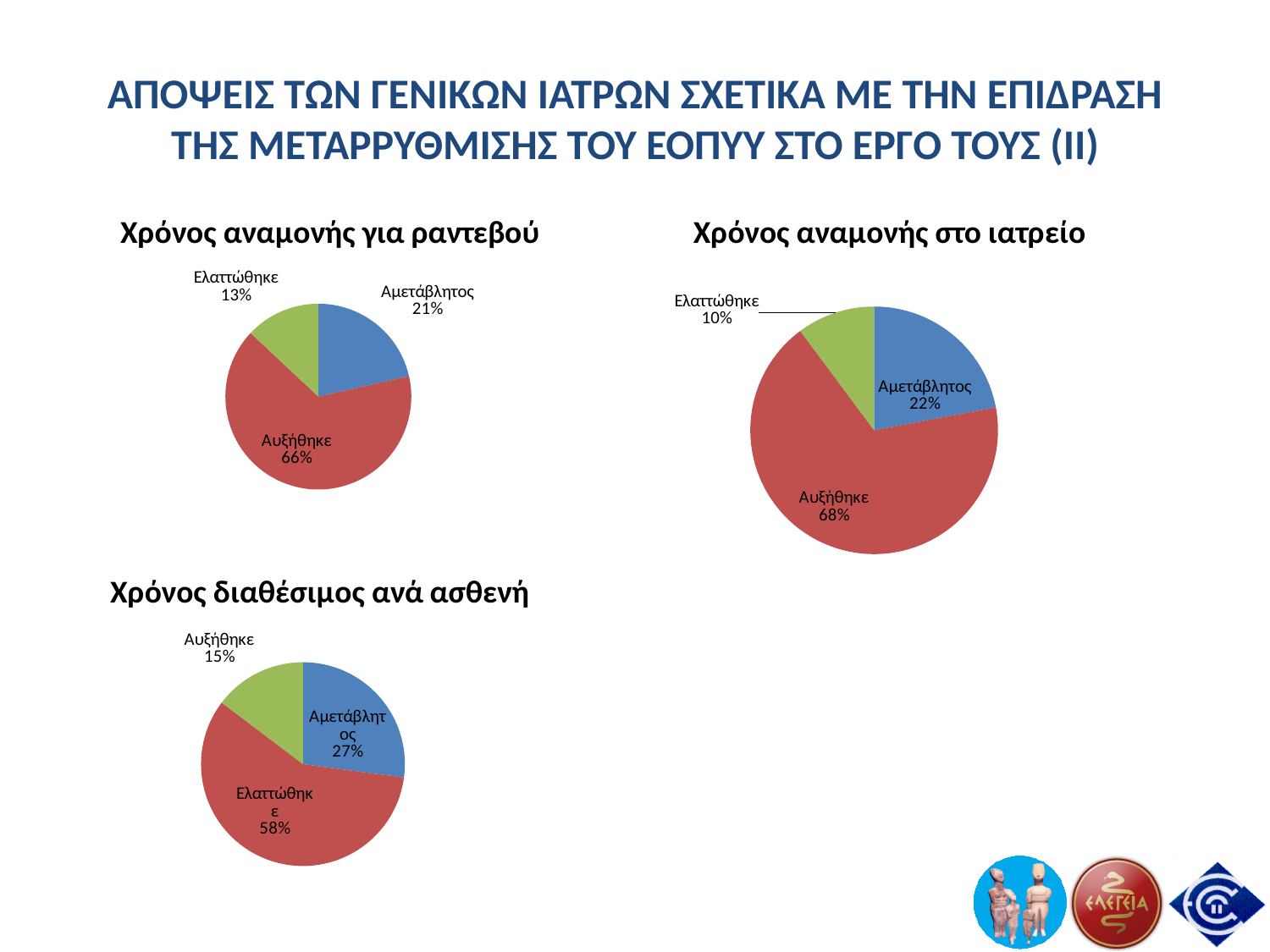
In the chart titled "Χρόνος αναμονής στο ιατρείο", what share is labelled "Αμετάβλητος"? 22% In the chart titled "Χρόνος αναμονής για ραντεβού", what colour is the "Αυξήθηκε" slice? Red How many slices does the chart titled "Χρόνος διαθέσιμος ανά ασθενή" have? 3 In the chart titled "Χρόνος αναμονής για ραντεβού", what share is labelled "Αυξήθηκε"? 66% In the chart titled "Χρόνος διαθέσιμος ανά ασθενή", which category has the smallest slice? Αυξήθηκε In the chart titled "Χρόνος διαθέσιμος ανά ασθενή", what share is labelled "Ελαττώθηκε"? 58% How many charts are shown on the slide? 3 In the chart titled "Χρόνος αναμονής στο ιατρείο", which is larger, "Αμετάβλητος" or "Ελαττώθηκε"? Αμετάβλητος In the chart titled "Χρόνος αναμονής για ραντεβού", what is the difference in percentage points between "Αυξήθηκε" and "Αμετάβλητος"? 45 What type of chart is the chart titled "Χρόνος αναμονής στο ιατρείο"? Pie chart In the chart titled "Χρόνος αναμονής για ραντεβού", what share is labelled "Ελαττώθηκε"? 13% In the chart titled "Χρόνος αναμονής στο ιατρείο", which category has the largest slice? Αυξήθηκε